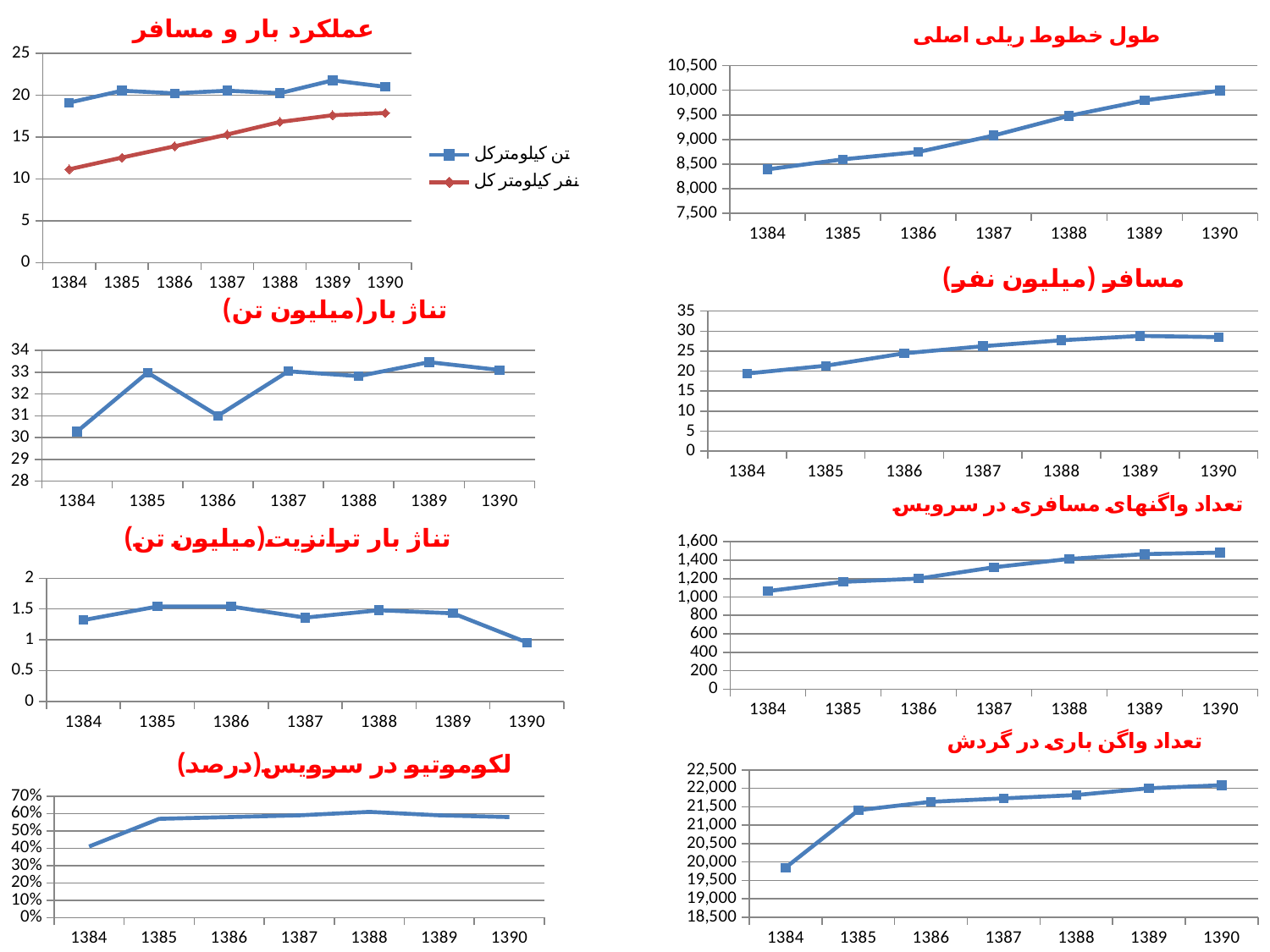
In the chart "مسافر (میلیون نفر)", is the value for 1384 greater or less than 25? less In the top-right chart "طول خطوط ریلی اصلی", is the value for 1384 greater or less than 8,500? less In the bottom-right chart "تعداد واگن باری در گردش", is the value for 1384 greater or less than 20,000? less How many years are plotted on the x axis of the chart "تناژ بار(میلیون تن)"? 7 What kind of chart is the top-left chart titled "عملکرد بار و مسافر"? line chart In the top-right chart "طول خطوط ریلی اصلی", do the values rise or fall from 1384 to 1390? rise How many series does the legend of the top-left chart "عملکرد بار و مسافر" list? 2 In the top-left chart "عملکرد بار و مسافر", which series is higher in 1384, "تن کیلومترکل" or "نفر کیلومتر کل"? تن کیلومترکل In the chart "تناژ بار(میلیون تن)", which year has the lowest value? 1384 In the chart "لکوموتیو در سرویس(درصد)", which year has the lowest value? 1384 In the chart "تناژ بار ترانزیت(میلیون تن)", which year has the lowest value? 1390